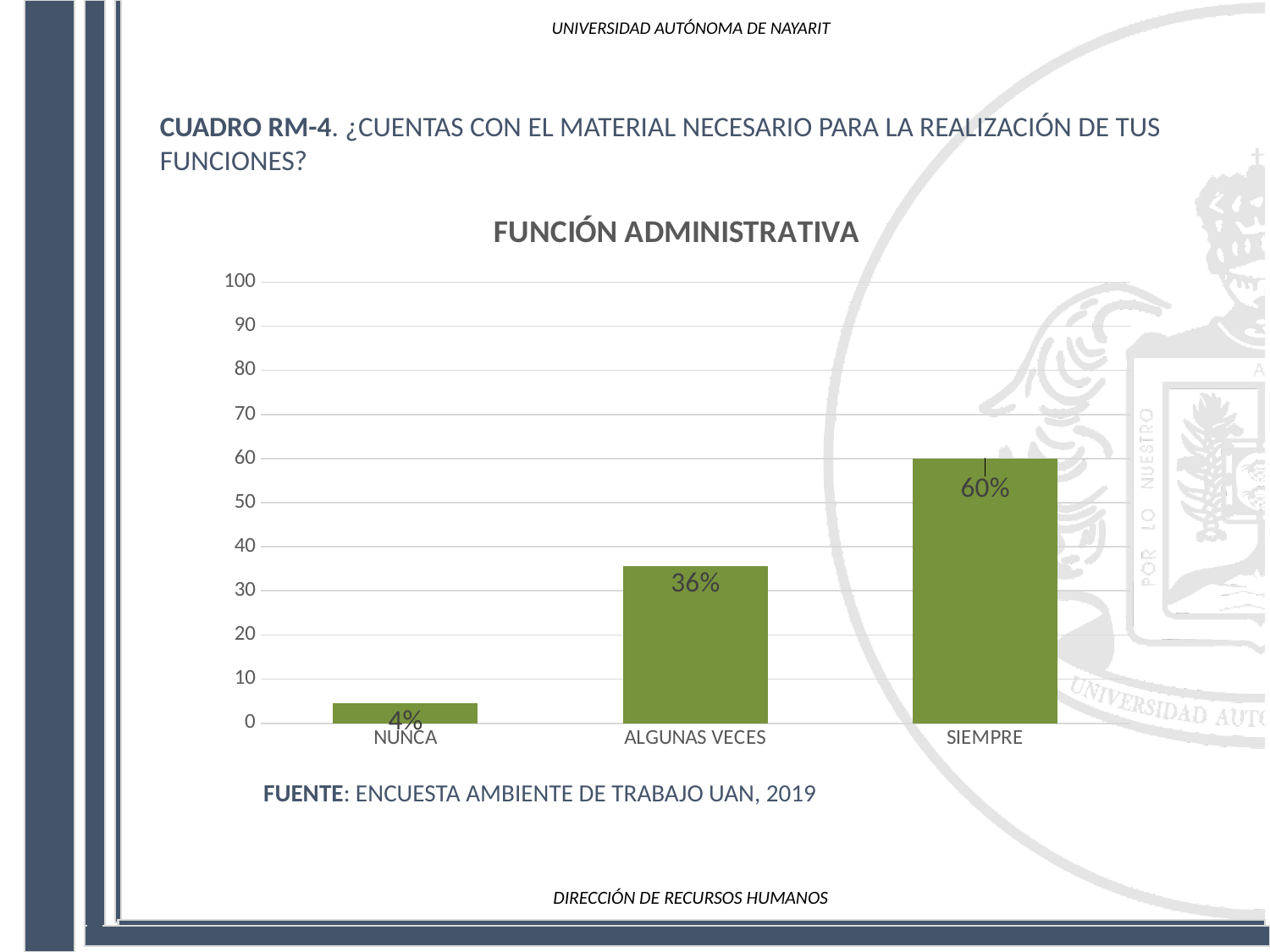
What kind of chart is shown? bar chart Which category has the highest value? SIEMPRE Which category has the lowest value? NUNCA Which is larger, the value for ALGUNAS VECES or the value for NUNCA? ALGUNAS VECES What is the title of the chart? FUNCIÓN ADMINISTRATIVA What is the value for SIEMPRE? 60% What is the difference between the values for ALGUNAS VECES and NUNCA? 32% What is the difference between the values for SIEMPRE and ALGUNAS VECES? 24% What is the value for ALGUNAS VECES? 36% Is the value for SIEMPRE greater or less than 50? greater What is the value for NUNCA? 4% How many categories are shown on the x axis? 3